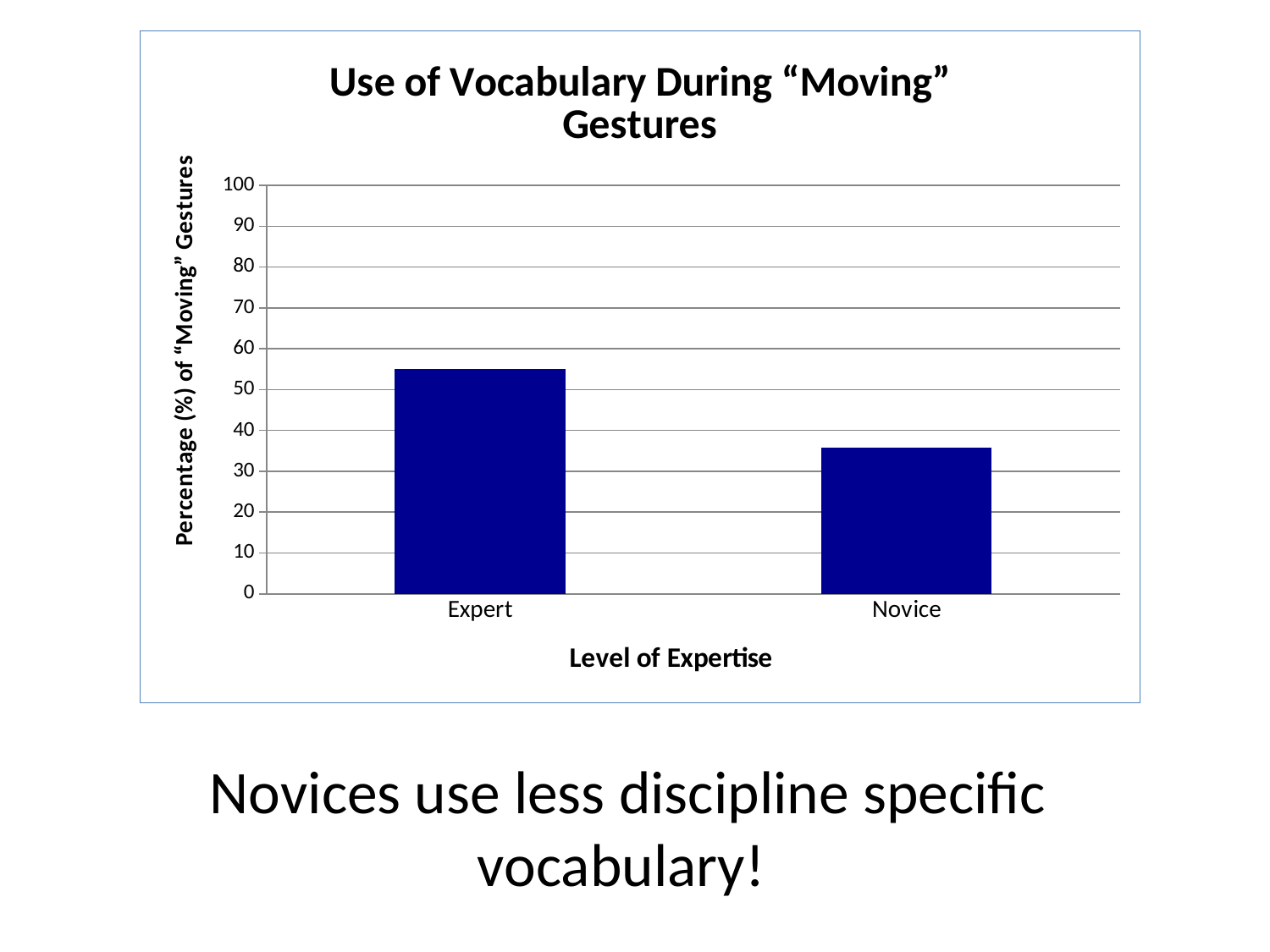
Is the value for Novice greater or less than 40? less Which level of expertise has the highest percentage of "Moving" gestures? Expert How many categories are plotted on the x axis? 2 Which is larger, the value for Expert or the value for Novice? Expert Is the value for Expert greater or less than 50? greater What is the title of the chart? Use of Vocabulary During "Moving" Gestures Is the value for Novice greater or less than 30? greater Do the values rise or fall from Expert to Novice along the x axis? fall What is the label of the x axis? Level of Expertise Which level of expertise has the lowest percentage of "Moving" gestures? Novice What kind of chart is shown on the slide? bar chart